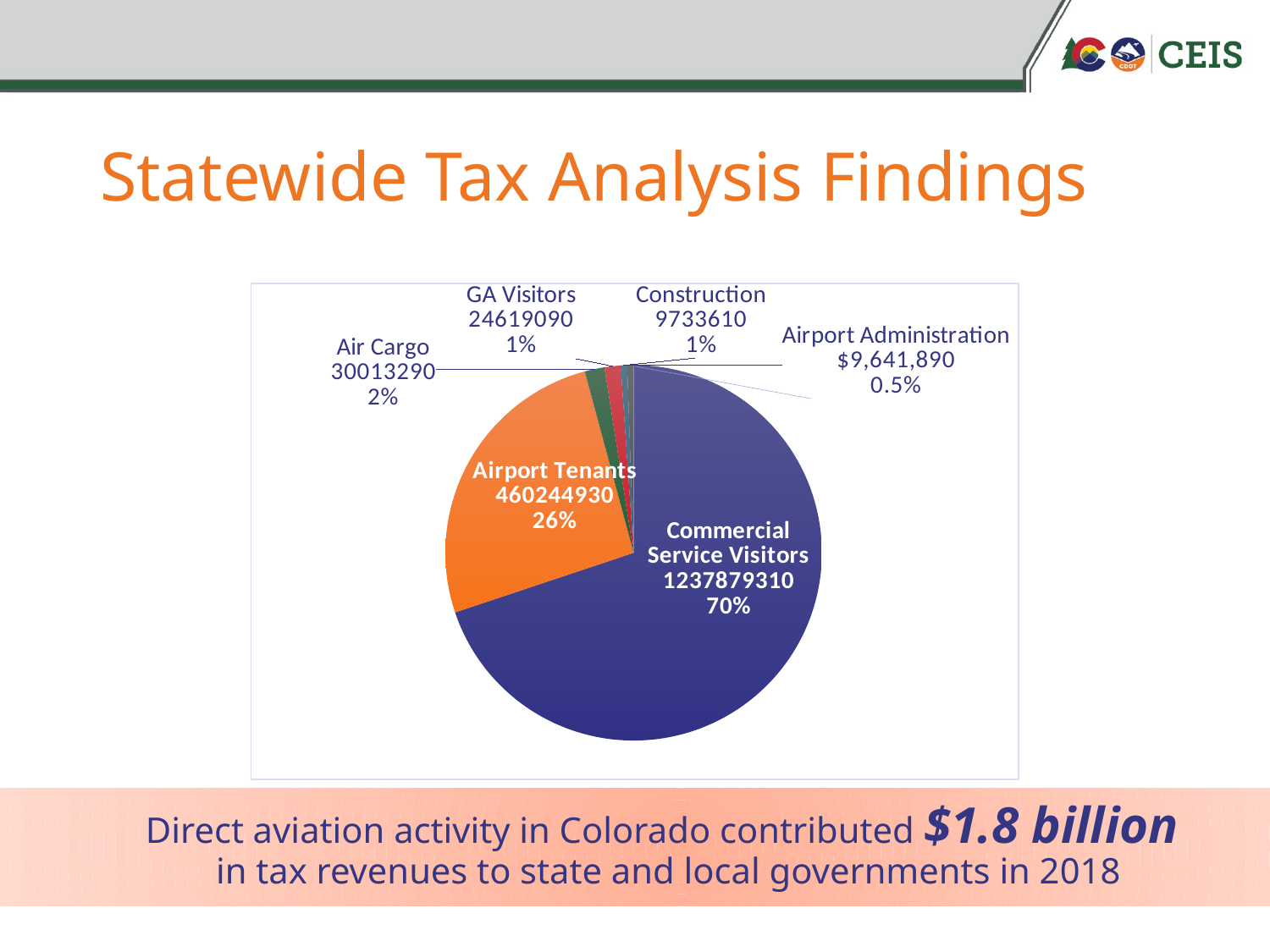
What is the value shown for Air Cargo? 30013290 Which category has the largest slice of the pie? Commercial Service Visitors Which is larger, the value for GA Visitors or the value for Construction? GA Visitors What is the difference between the values for Air Cargo and GA Visitors? 5394200 How many slices does the pie chart have? 6 What share of the pie does Airport Administration represent? 0.5% What is the value shown for Airport Administration? $9,641,890 What is the value shown for Airport Tenants? 460244930 Which category has the smallest slice of the pie? Airport Administration What share of the pie does Airport Tenants represent? 26% What kind of chart is shown on the slide? Pie chart What is the value shown for Commercial Service Visitors? 1237879310